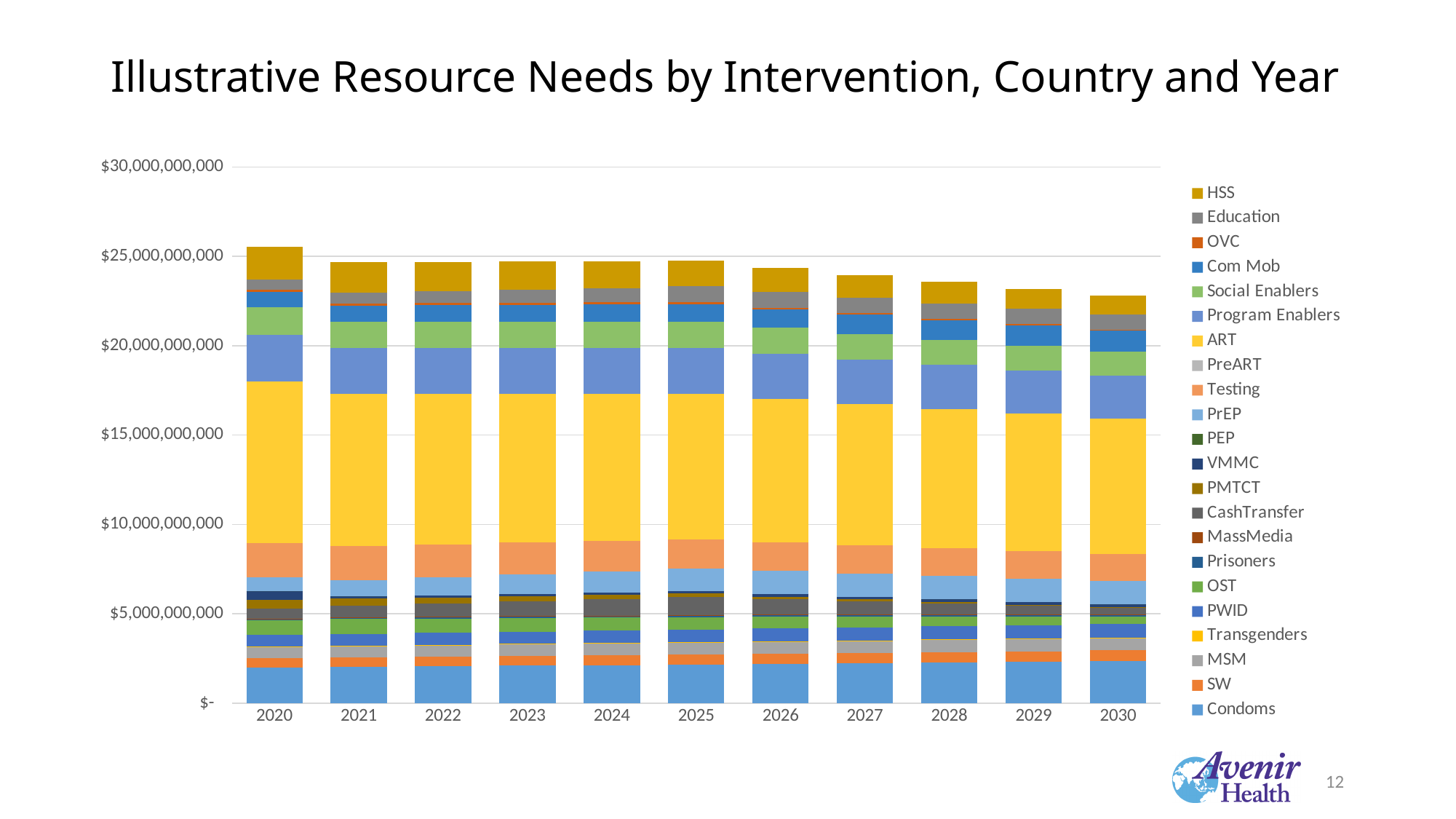
Do the total resource needs generally rise or fall from 2026 to 2030? fall How many years are shown along the x axis of the chart? 11 Which intervention makes up the largest segment of each stacked bar? ART Which year has the highest total resource need? 2020 Which year has a larger total resource need, 2020 or 2030? 2020 Is the total resource need for 2020 greater or less than $25,000,000,000? greater How many series does the chart's legend list? 22 What is the title of the chart? Illustrative Resource Needs by Intervention, Country and Year Which year has the lowest total resource need? 2030 What kind of chart is shown on the slide? Stacked bar chart Is the total resource need for 2027 greater or less than $20,000,000,000? greater Is the total resource need for 2030 greater or less than $25,000,000,000? less